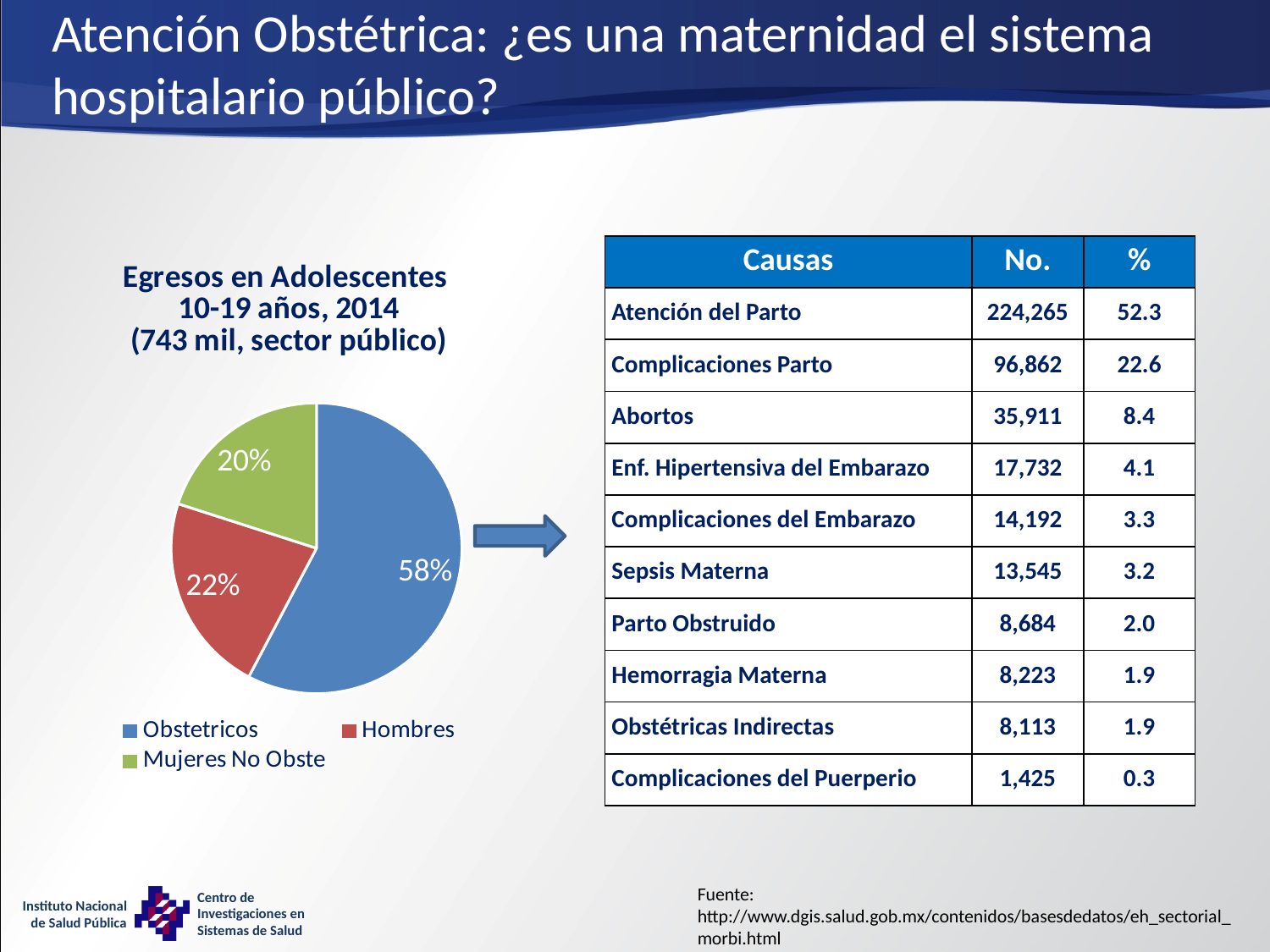
How many slices does the pie chart have? 3 What share of the pie chart does Obstetricos represent? 58% What is the difference in percentage points between the Obstetricos slice and the Hombres slice? 36 Which category has the largest slice in the pie chart? Obstetricos What share of the pie chart does Mujeres No Obste represent? 20% What kind of chart is shown on the slide? pie chart Which slice is larger in the pie chart, Hombres or Mujeres No Obste? Hombres What share of the pie chart does Hombres represent? 22% What is the title of the pie chart? Egresos en Adolescentes 10-19 años, 2014 (743 mil, sector público) How many entries does the pie chart legend list? 3 What colour is the Obstetricos slice in the pie chart? blue Which category has the smallest slice in the pie chart? Mujeres No Obste